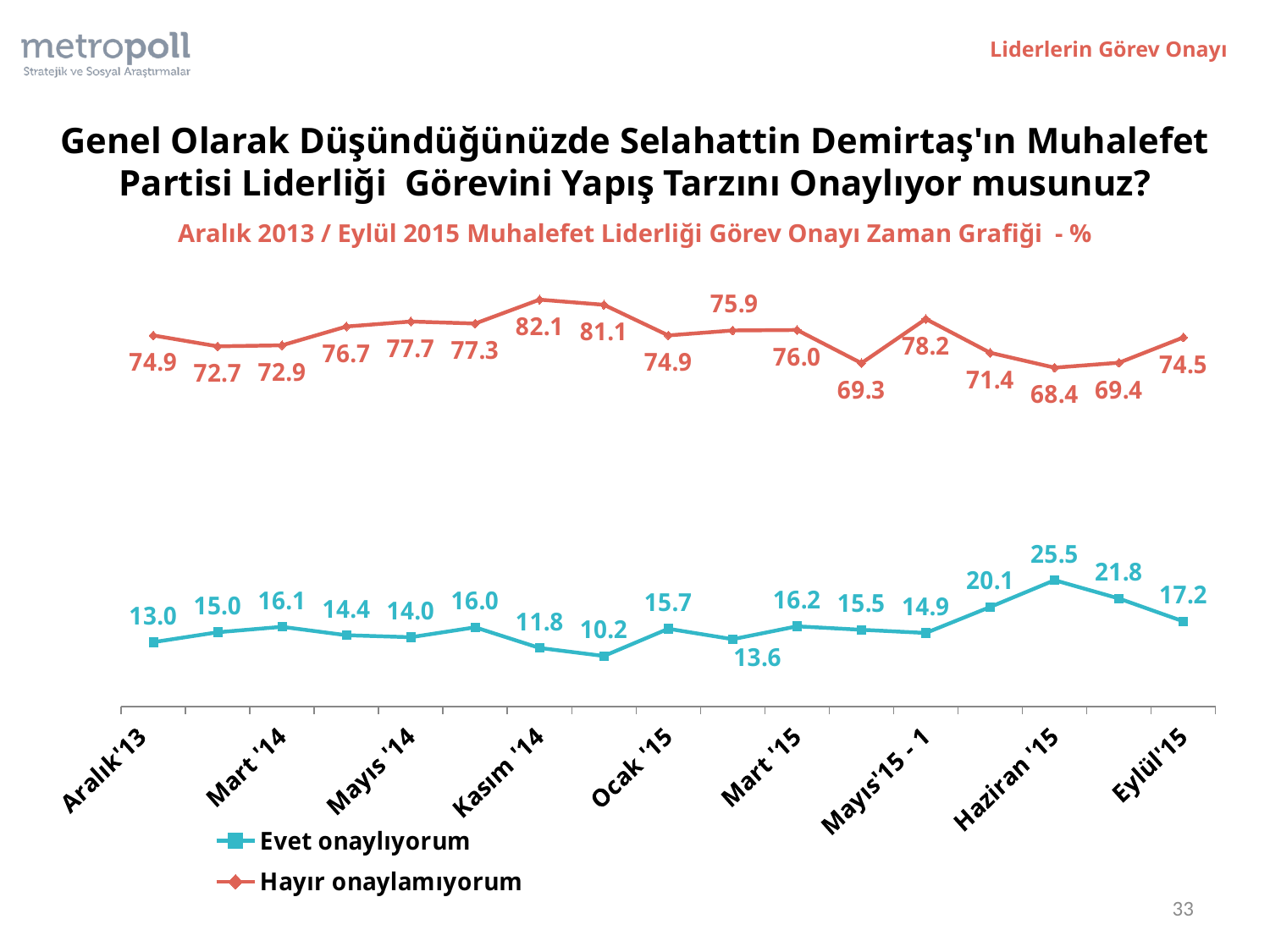
What is the value of the 'Hayır onaylamıyorum' series at Kasım '14? 82.1 What is the value of the 'Evet onaylıyorum' series at Haziran '15? 25.5 Which series is drawn in red? Hayır onaylamıyorum What is the value of the 'Hayır onaylamıyorum' series at Eylül'15? 74.5 What is the highest value shown for the 'Hayır onaylamıyorum' series? 82.1 What is the lowest value shown for the 'Evet onaylıyorum' series? 10.2 What is the lowest value shown for the 'Hayır onaylamıyorum' series? 68.4 What is the value of the 'Evet onaylıyorum' series at Aralık'13? 13.0 What kind of chart is shown on the slide? Line chart How many series does the legend list? 2 Which is larger for 'Evet onaylıyorum': the value at Mart '15 or the value at Eylül'15? Eylül'15 What is the difference between the 'Hayır onaylamıyorum' and 'Evet onaylıyorum' values at Haziran '15? 42.9